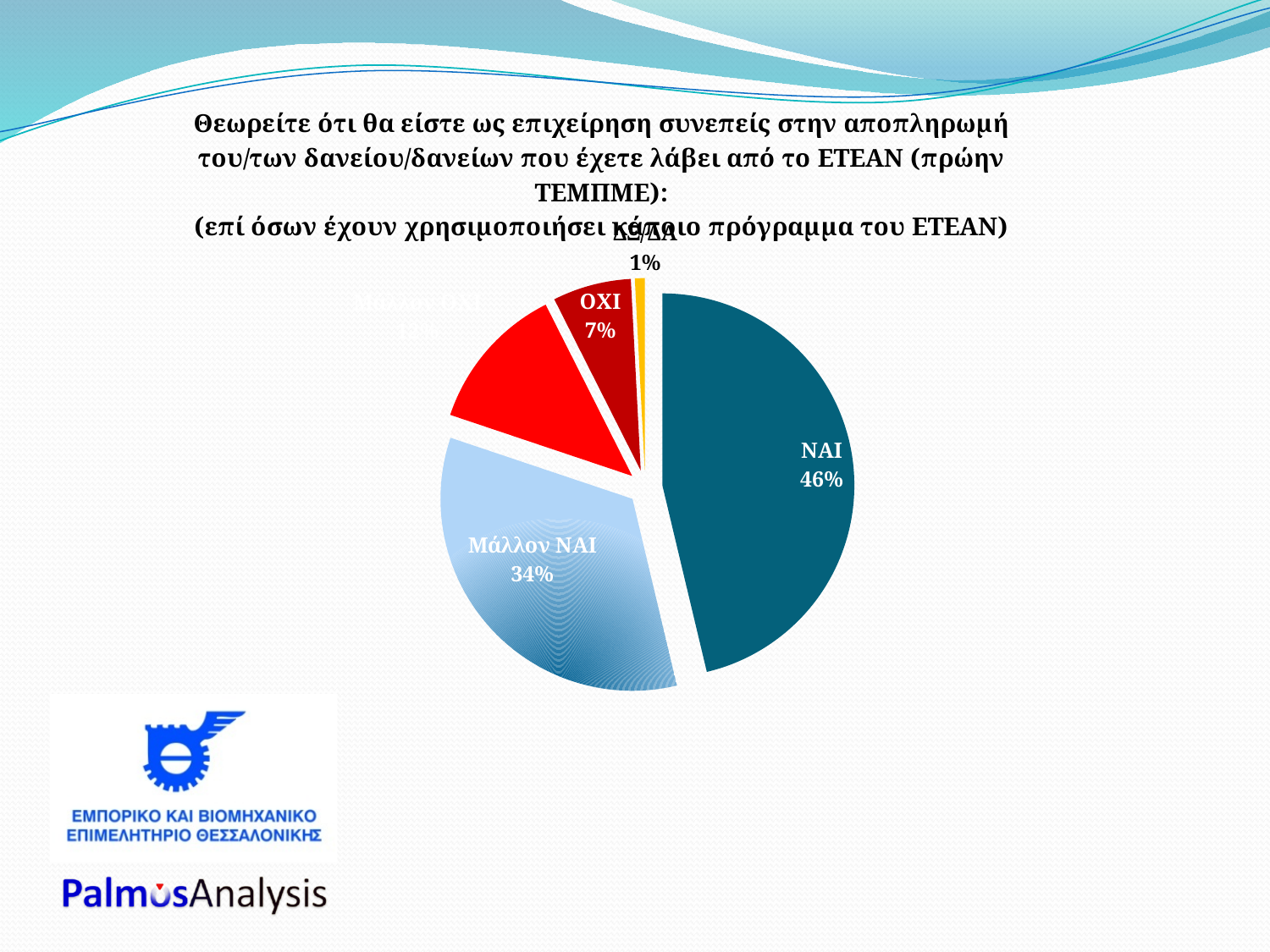
How many slices does the pie chart have? 5 How many percentage points larger is ΝΑΙ than Μάλλον ΝΑΙ? 12 percentage points What kind of chart is shown on the slide? Pie chart What percentage is shown for ΔΞ/ΔΑ? 1% What colour is the ΝΑΙ slice? Dark teal What percentage is shown for ΟΧΙ? 7% What is the combined share of ΝΑΙ and Μάλλον ΝΑΙ? 80% What percentage is shown for Μάλλον ΝΑΙ? 34% Which slice of the pie is the smallest? ΔΞ/ΔΑ Which is larger, the ΟΧΙ slice or the ΔΞ/ΔΑ slice? ΟΧΙ Which slice of the pie is the largest? ΝΑΙ What percentage of the pie is the ΝΑΙ slice? 46%